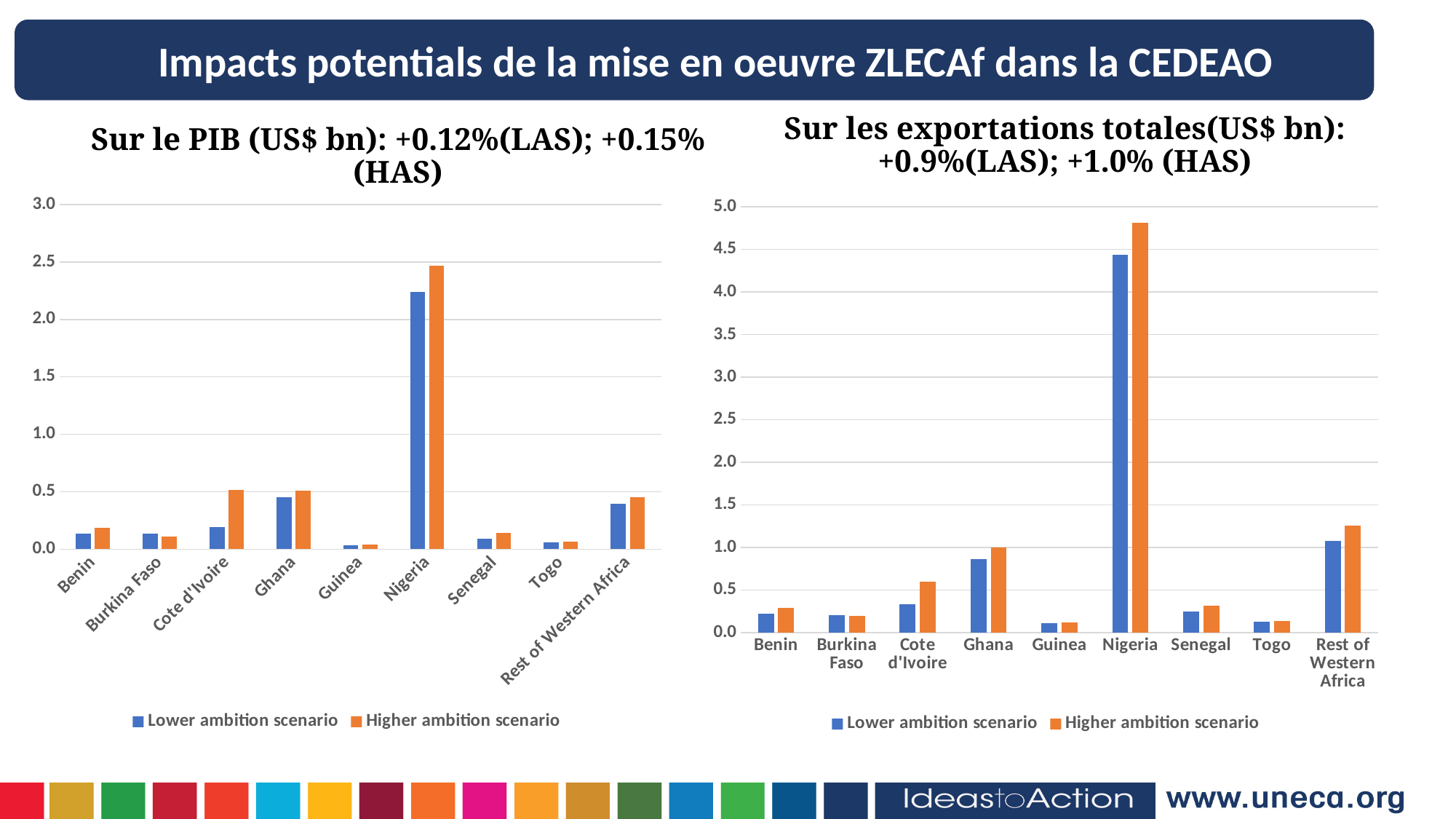
In the left chart 'Sur le PIB (US$ bn)', which is larger in the Lower ambition scenario: Nigeria or Ghana? Nigeria What kind of chart is the left chart, 'Sur le PIB (US$ bn)'? bar chart In the right chart 'Sur les exportations totales (US$ bn)', which is larger in the Higher ambition scenario: Ghana or Cote d'Ivoire? Ghana In the right chart 'Sur les exportations totales (US$ bn)', how many series does the legend list? 2 In the right chart 'Sur les exportations totales (US$ bn)', which country has the highest value in the Lower ambition scenario? Nigeria In the left chart 'Sur le PIB (US$ bn)', is the Higher ambition scenario value for Nigeria greater or less than 2.0? greater In the right chart 'Sur les exportations totales (US$ bn)', is the Lower ambition scenario value for Ghana greater or less than 1.0? less In the left chart 'Sur le PIB (US$ bn)', which country has the lowest value in the Lower ambition scenario? Guinea In the right chart 'Sur les exportations totales (US$ bn)', is the Higher ambition scenario value for Nigeria greater or less than 4.5? greater In the left chart 'Sur le PIB (US$ bn)', which country has the highest value in the Higher ambition scenario? Nigeria In the left chart 'Sur le PIB (US$ bn)', which colour represents the Higher ambition scenario? orange In the left chart 'Sur le PIB (US$ bn)', how many countries/regions are shown on the x axis? 9